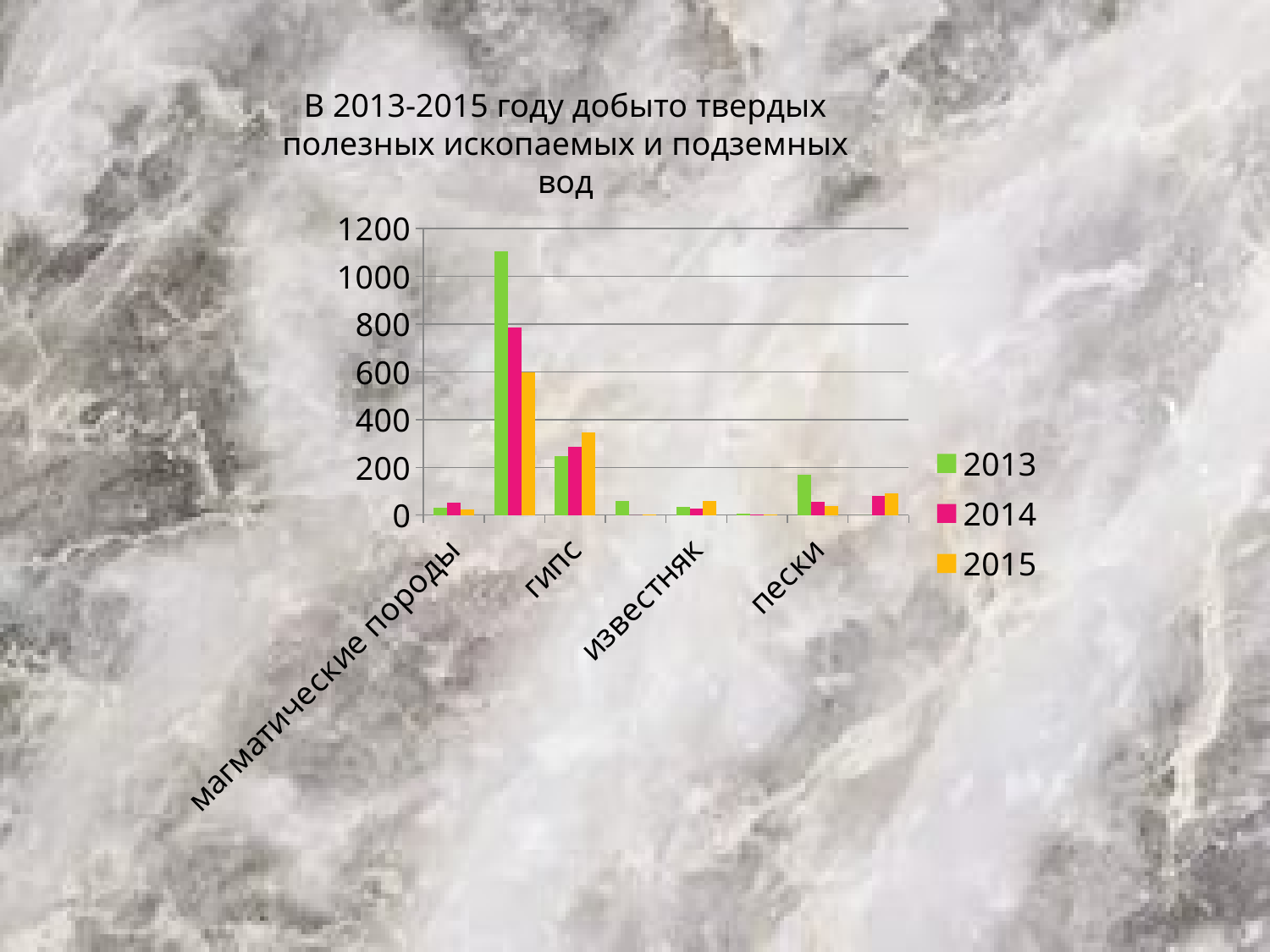
Is the 2015 value for известняк greater or less than 200? less For гипс, which year has the highest value? 2015 What is the highest value shown on the vertical axis? 1200 Is the 2015 value for гипс greater or less than 400? less What kind of chart is shown on the slide? bar chart Is the 2013 value for пески greater or less than 100? greater For гипс, which is larger: the 2013 value or the 2015 value? 2015 For пески, which is larger: the 2013 value or the 2014 value? 2013 For гипс, do the values rise or fall from 2013 to 2015? rise How many series does the legend list? 3 What are the entries in the chart's legend? 2013, 2014, 2015